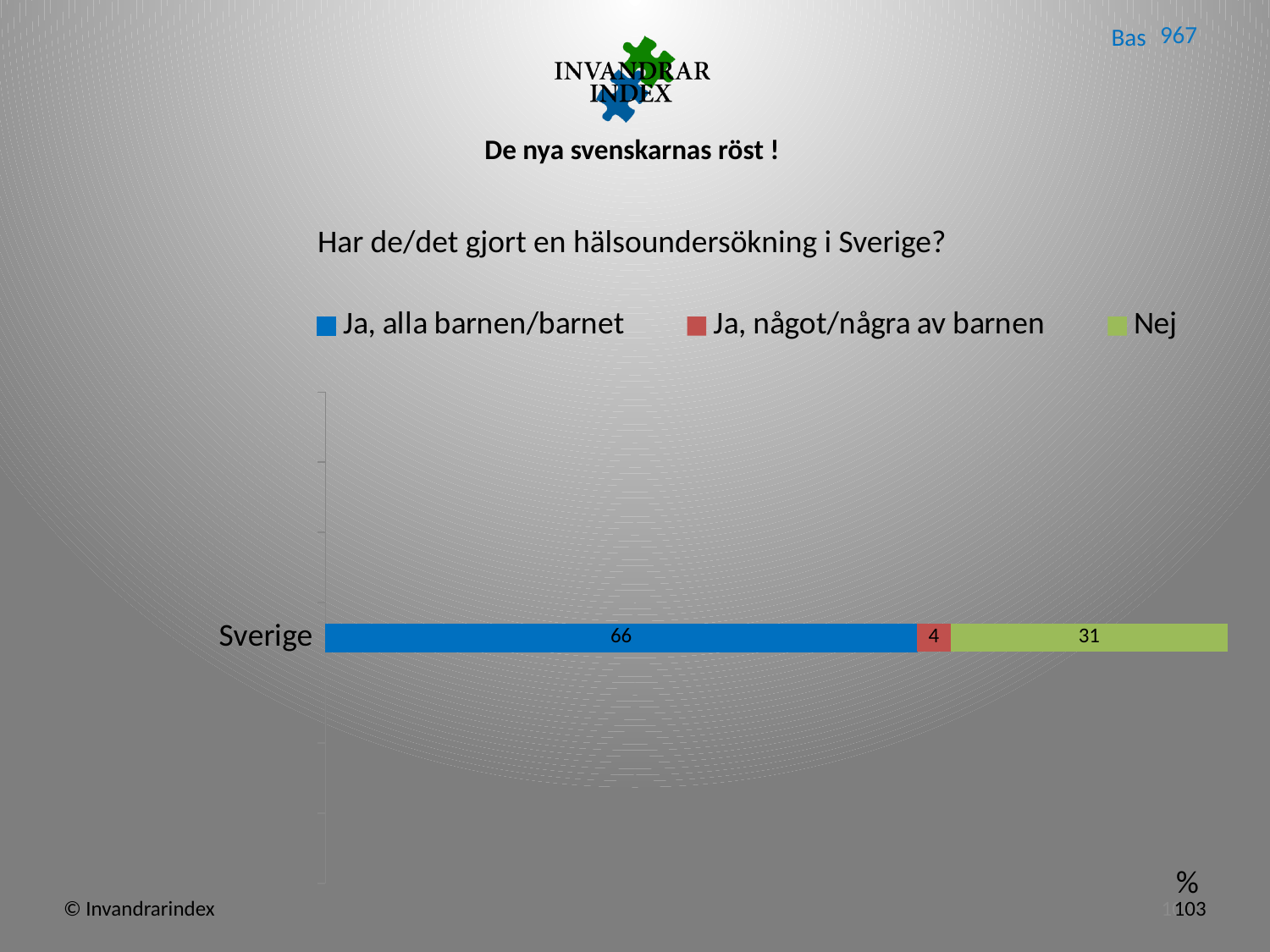
What kind of chart is shown on the slide? Stacked bar chart How many series does the legend list? 3 What is the value for "Nej" for Sverige? 31 Which series has the lowest value for Sverige? Ja, något/några av barnen What is the value for "Ja, något/några av barnen" for Sverige? 4 How many categories are plotted on the chart? 1 Which is larger for Sverige: "Nej" or "Ja, något/några av barnen"? Nej What is the value for "Ja, alla barnen/barnet" for Sverige? 66 What is the total of the stacked bar for Sverige? 101 What is the difference between the "Ja, alla barnen/barnet" value and the "Nej" value for Sverige? 35 What question is the chart about, as shown in its title? Har de/det gjort en hälsoundersökning i Sverige? Which series has the highest value for Sverige? Ja, alla barnen/barnet